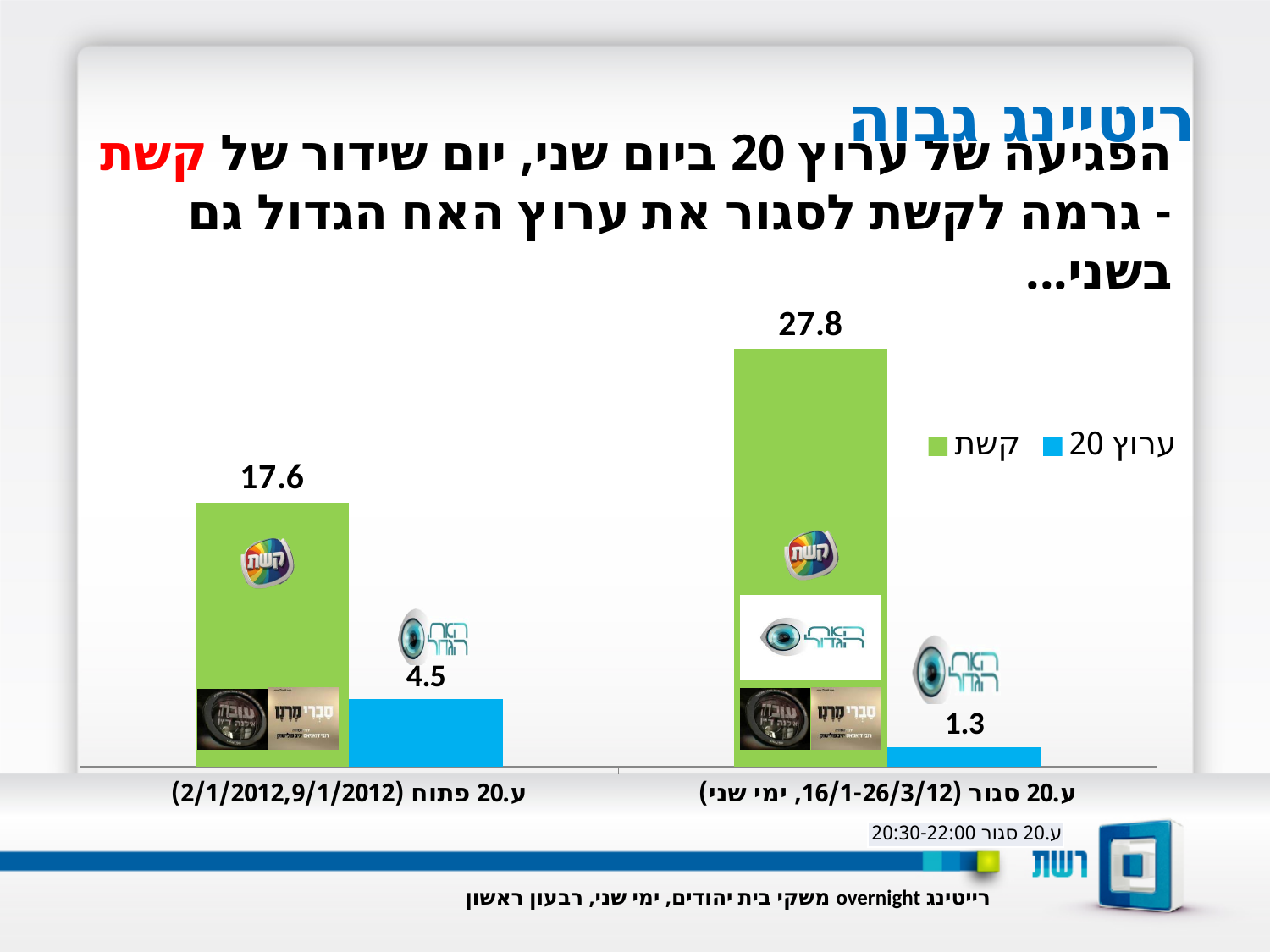
Which is larger: the קשת value in ע.20 פתוח or the קשת value in ע.20 סגור? ע.20 סגור Which bar has the lowest value on the chart? ערוץ 20 in ע.20 סגור (16/1-26/3/12, ימי שני) What kind of chart is shown on the slide? bar chart What is the value for קשת in the category ע.20 סגור (16/1-26/3/12, ימי שני)? 27.8 What is the difference between the קשת values in the two categories? 10.2 What is the difference between the ערוץ 20 values in the two categories? 3.2 How many categories are shown on the x axis? 2 What is the value for ערוץ 20 in the category ע.20 סגור (16/1-26/3/12, ימי שני)? 1.3 What is the value for ערוץ 20 in the category ע.20 פתוח (2/1/2012,9/1/2012)? 4.5 What is the value for קשת in the category ע.20 פתוח (2/1/2012,9/1/2012)? 17.6 Which bar has the highest value on the chart? קשת in ע.20 סגור (16/1-26/3/12, ימי שני) How many series does the legend list? 2